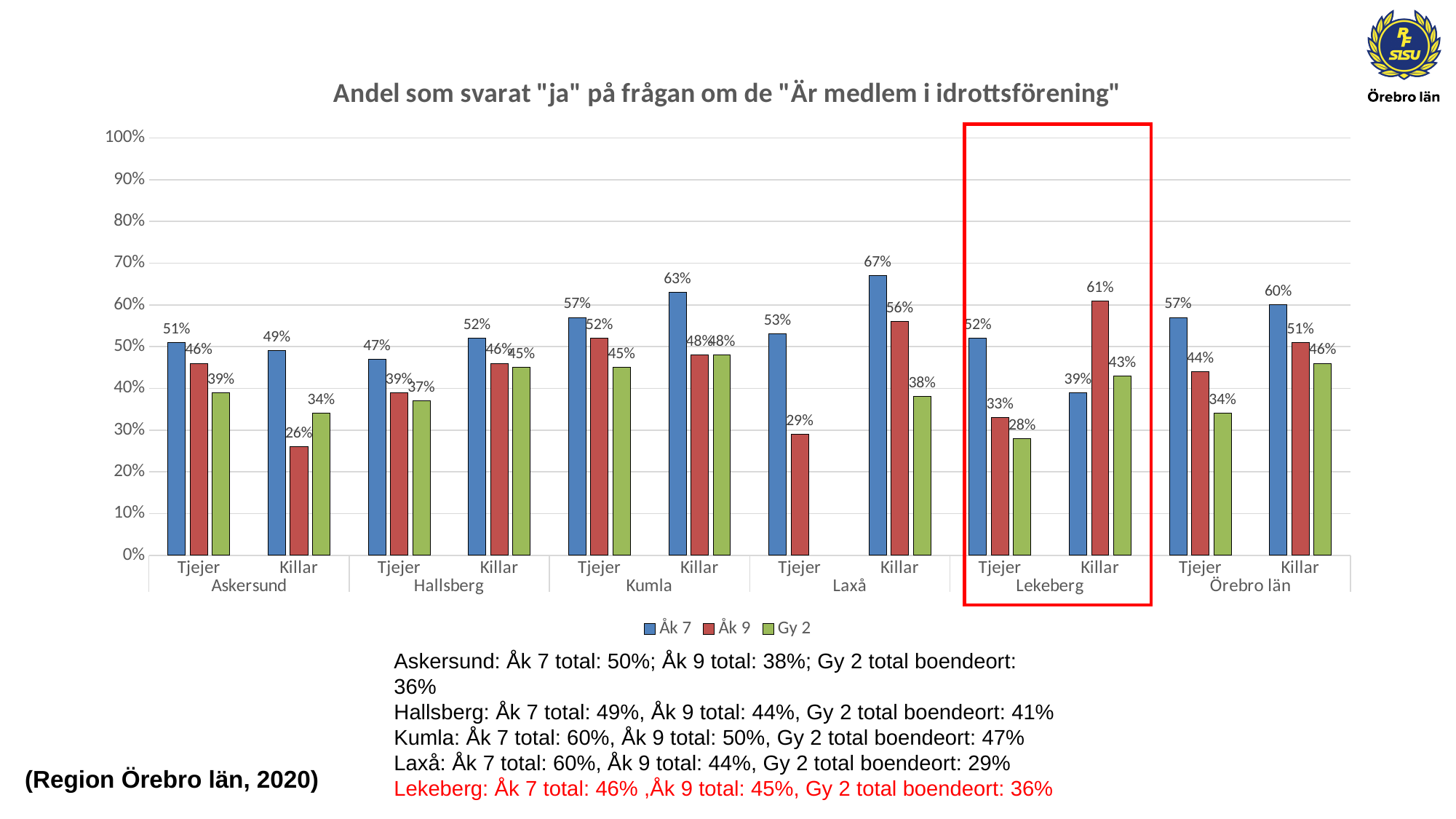
How many municipalities/regions are shown on the x axis? 6 For Killar in Lekeberg, which is larger: the Åk 7 value or the Åk 9 value? Åk 9 What is the difference between the Åk 7 and Åk 9 values for Tjejer in Laxå? 24 percentage points How many series does the legend list? 3 Which group has the lowest Åk 9 value? Killar, Askersund Is the Gy 2 value for Killar in Örebro län greater or less than 40%? greater What is the Gy 2 value for Tjejer in Askersund? 39% What kind of chart is shown on the slide? Bar chart Which municipality is highlighted with a red box on the chart? Lekeberg What is the Åk 7 value for Killar in Laxå? 67% What is the Åk 9 value for Killar in Lekeberg? 61% Which group has the highest Åk 7 value? Killar, Laxå